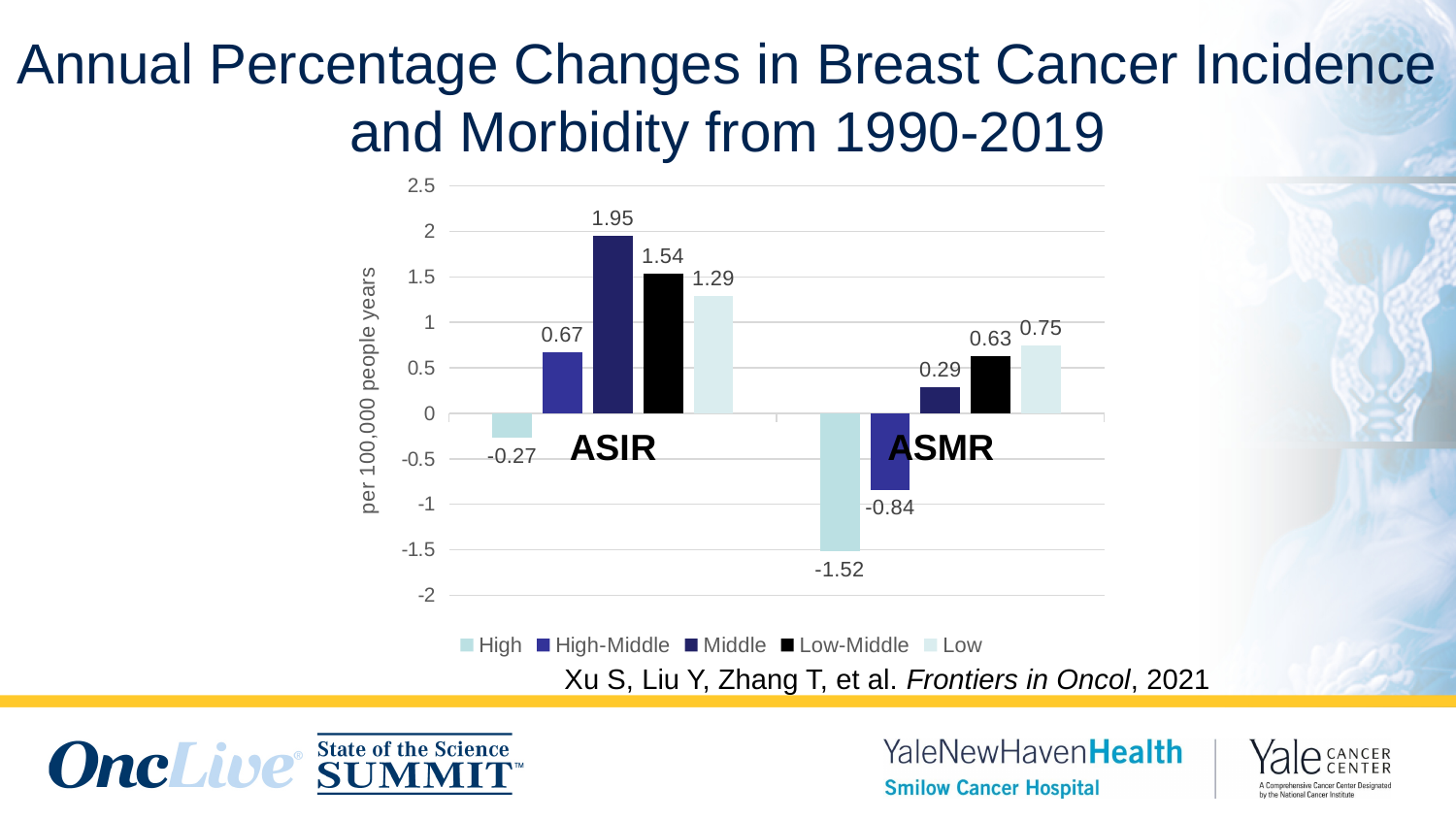
What is the value for the Middle series in the ASIR group? 1.95 What is the value for the High series in the ASMR group? -1.52 Which series has the lowest value in the ASMR group? High Which series has the highest value in the ASIR group? Middle Which is larger in the ASMR group, the Low value or the Low-Middle value? Low What is the value for the Low-Middle series in the ASIR group? 1.54 What is the value for the High-Middle series in the ASMR group? -0.84 How many series does the legend list? 5 What is the label on the vertical axis? per 100,000 people years What kind of chart is shown on the slide? Bar chart How many groups of bars are shown on the x axis? 2 What is the difference between the Middle and Low-Middle values in the ASIR group? 0.41